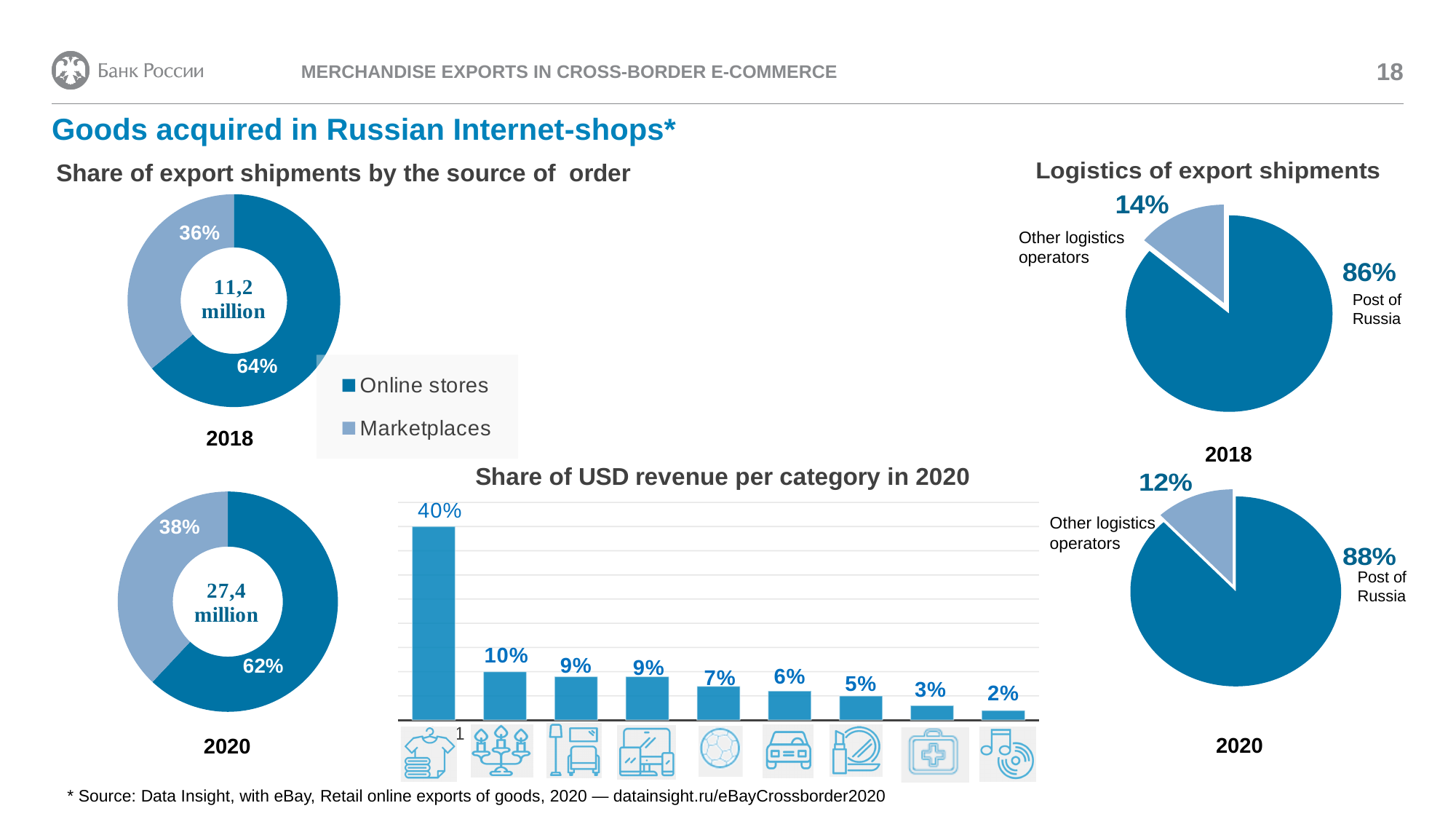
In the 2020 Logistics of export shipments pie chart, what share do Other logistics operators have? 12% In the 2020 donut chart for share of export shipments by the source of order, what share do Marketplaces have? 38% In the 2018 donut chart for share of export shipments by the source of order, what share do Marketplaces have? 36% In the 2020 donut chart for share of export shipments by the source of order, what total is shown in the centre? 27,4 million What kind of chart is the Share of USD revenue per category in 2020 chart? bar chart How many series does the legend of the share of export shipments by the source of order charts list? 2 In the Share of USD revenue per category in 2020 chart, what is the highest value shown? 40% In the 2018 Logistics of export shipments pie chart, what share does Post of Russia have? 86% In the 2018 donut chart for share of export shipments by the source of order, what share do Online stores have? 64% In the Logistics of export shipments charts, which is larger: the Post of Russia share in 2018 or in 2020? 2020 In the 2020 donut chart for share of export shipments by the source of order, what is the difference between the Online stores share and the Marketplaces share? 24% How many bars are in the Share of USD revenue per category in 2020 chart? 9